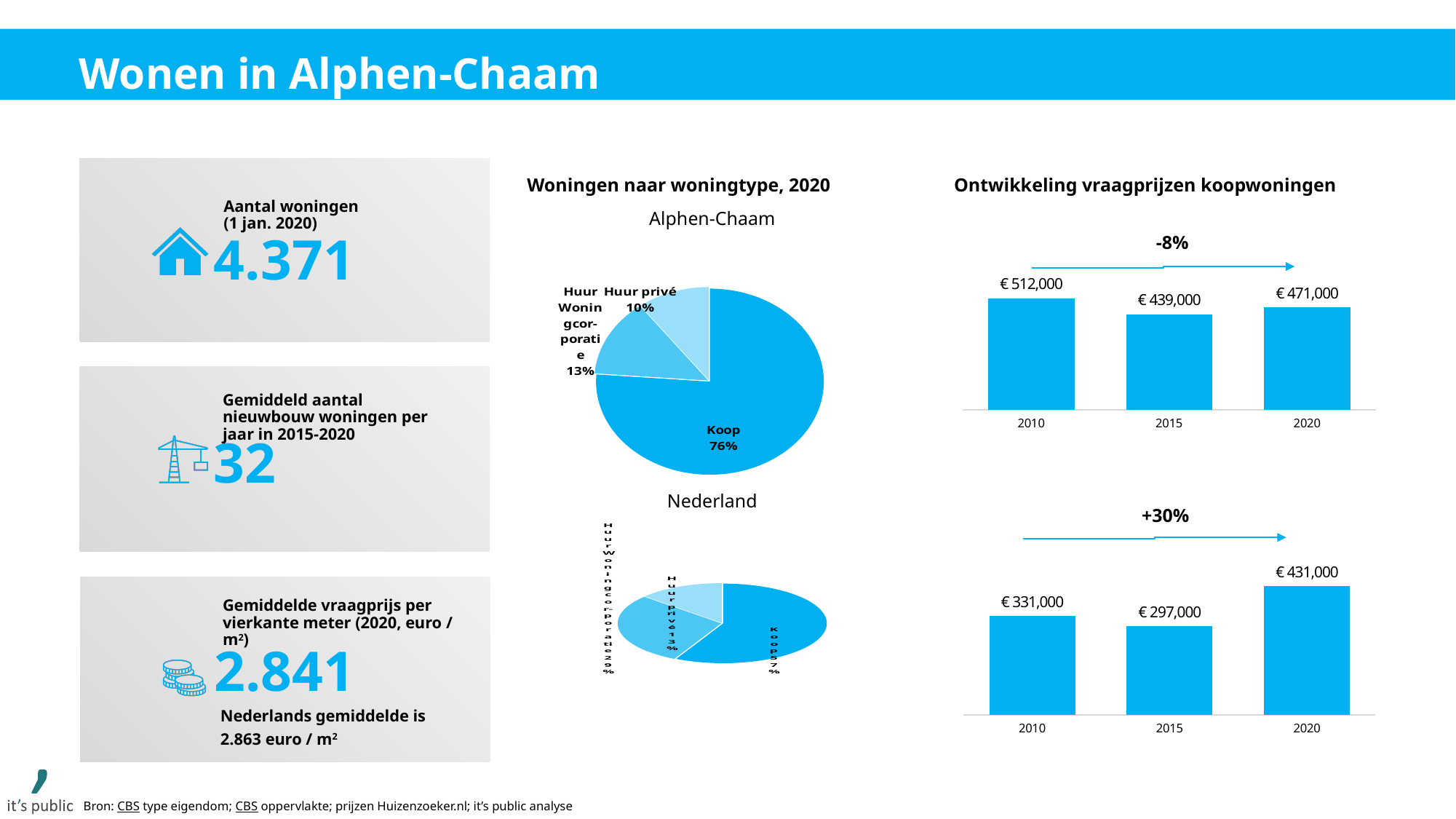
In the upper bar chart under 'Ontwikkeling vraagprijzen koopwoningen', which year has the lowest value? 2015 In the Alphen-Chaam pie chart, what share of homes is 'Koop'? 76% In the lower bar chart under 'Ontwikkeling vraagprijzen koopwoningen', what is the difference between the 2020 and 2010 values? € 100,000 What kind of chart is used for 'Ontwikkeling vraagprijzen koopwoningen'? Bar chart In the lower bar chart under 'Ontwikkeling vraagprijzen koopwoningen', what is the value for 2020? € 431,000 In the upper bar chart under 'Ontwikkeling vraagprijzen koopwoningen', what is the value for 2010? € 512,000 In the Alphen-Chaam pie chart, which category has the smallest slice? Huur privé In the upper bar chart under 'Ontwikkeling vraagprijzen koopwoningen', what is the value for 2015? € 439,000 In the Alphen-Chaam pie chart, what share of homes is 'Huur privé'? 10% In the Alphen-Chaam pie chart, which category has the largest slice? Koop In the Alphen-Chaam pie chart, what share of homes is 'Huur Woningcorporatie'? 13% How many slices does the Alphen-Chaam pie chart have? 3